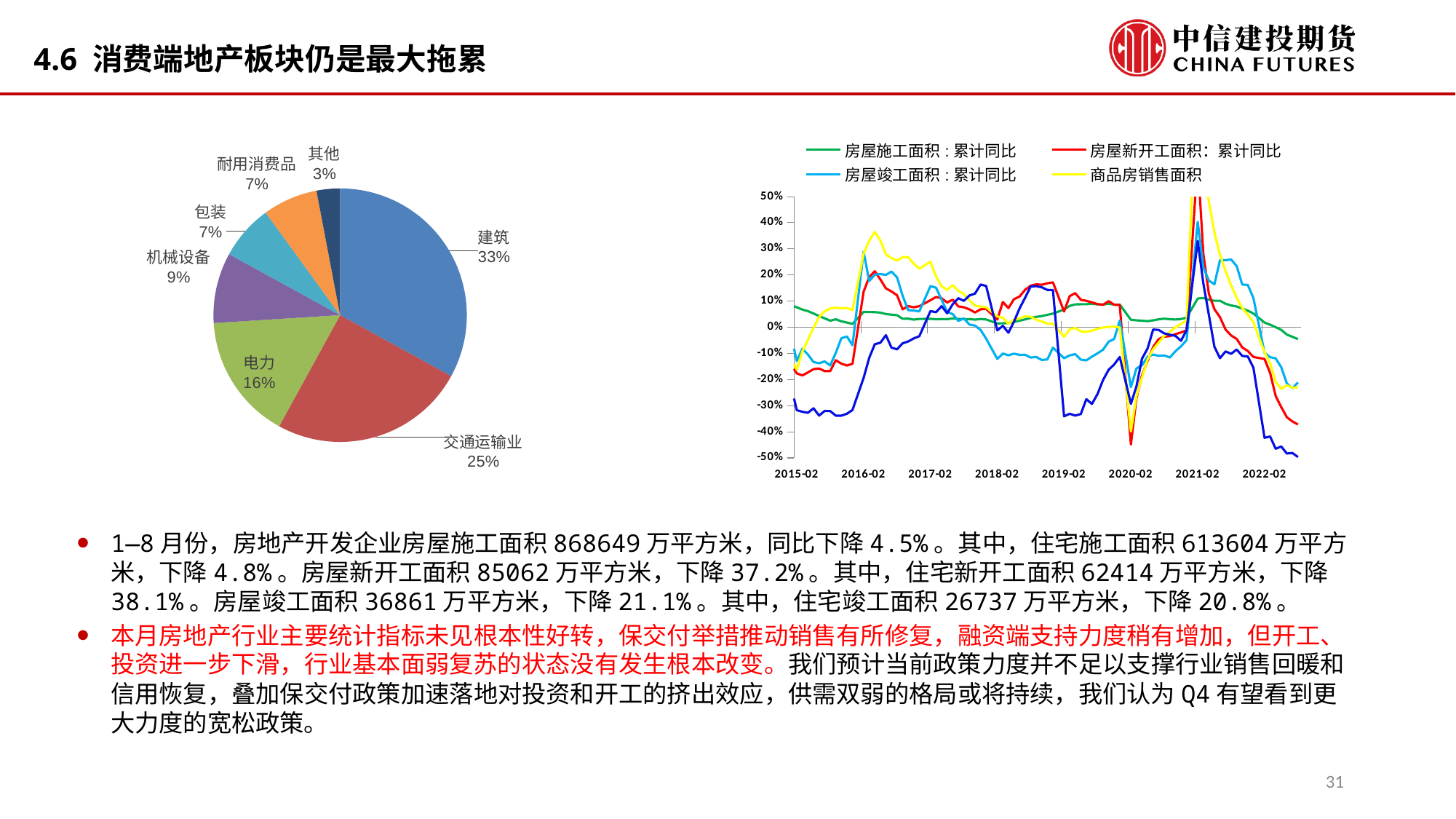
On the pie chart on the left, what is the difference in percentage points between 建筑 and 交通运输业? 8 percentage points On the pie chart on the left, what share does 建筑 have? 33% On the pie chart on the left, what share does 交通运输业 have? 25% How many slices does the pie chart on the left have? 7 On the pie chart on the left, what share does 电力 have? 16% On the pie chart on the left, which category has the largest share? 建筑 On the pie chart on the left, which is larger, 机械设备 or 电力? 电力 How many series does the legend of the line chart on the right list? 4 On the line chart on the right, is the value of 房屋新开工面积：累计同比 at the end of the series (2022) greater or less than -30%? less What kind of chart is the chart on the left of the slide? Pie chart On the line chart on the right, does 房屋施工面积:累计同比 rise or fall from 2021-02 to the end of the series? fall On the pie chart on the left, which category has the smallest share? 其他